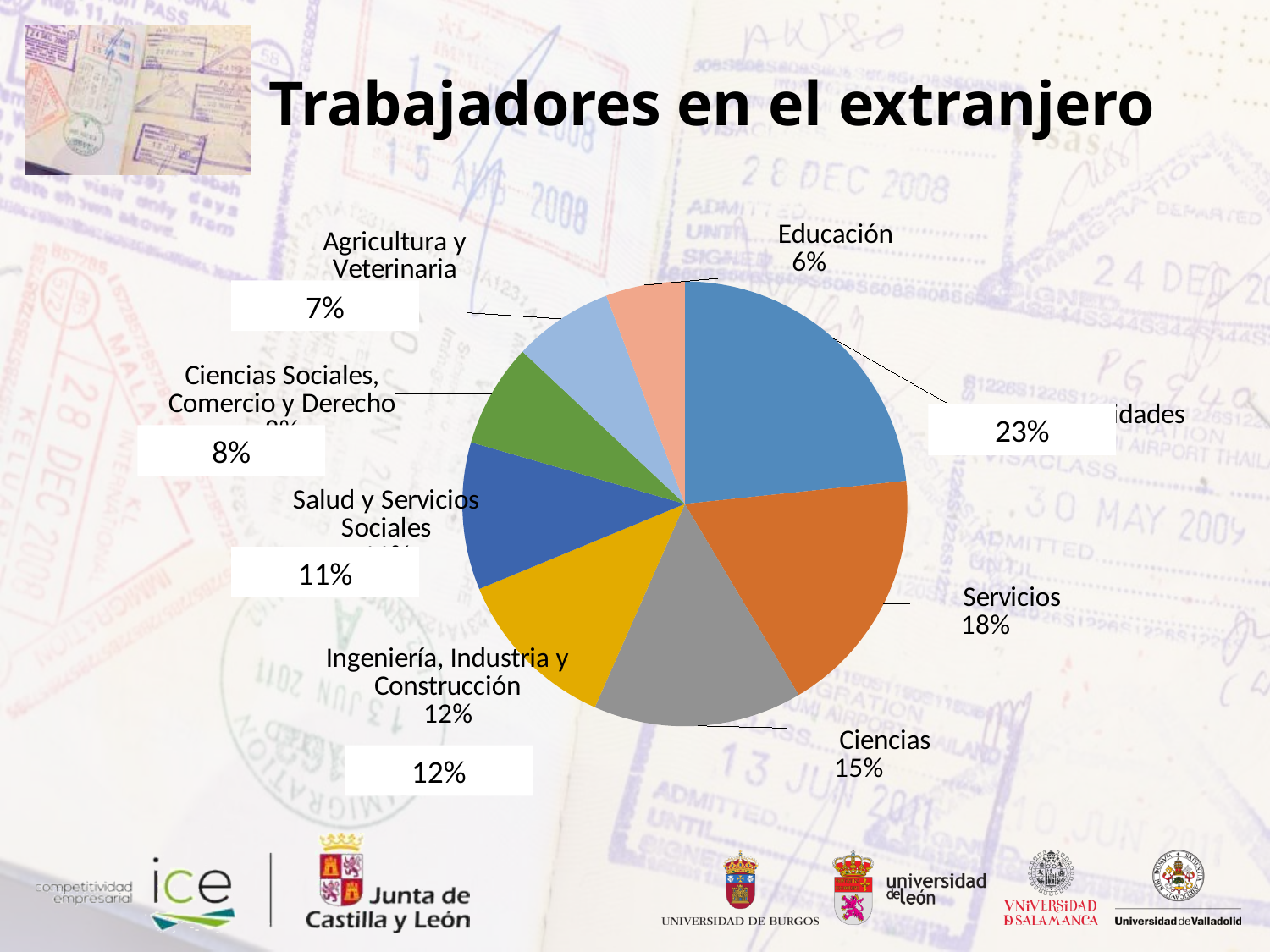
What percentage does the Servicios slice represent? 18% What is the title of the slide's chart? Trabajadores en el extranjero What percentage is shown for Agricultura y Veterinaria? 7% What percentage does the Ciencias slice represent? 15% What percentage is shown for Salud y Servicios Sociales? 11% How many slices does the pie chart have? 8 What percentage is shown for Ingeniería, Industria y Construcción? 12% What is the difference in percentage points between Servicios and Ciencias? 3% What is the largest percentage shown on the pie chart? 23% What percentage does the Educación slice represent? 6% What kind of chart is shown on the slide? pie chart Which category has the smallest slice of the pie? Educación